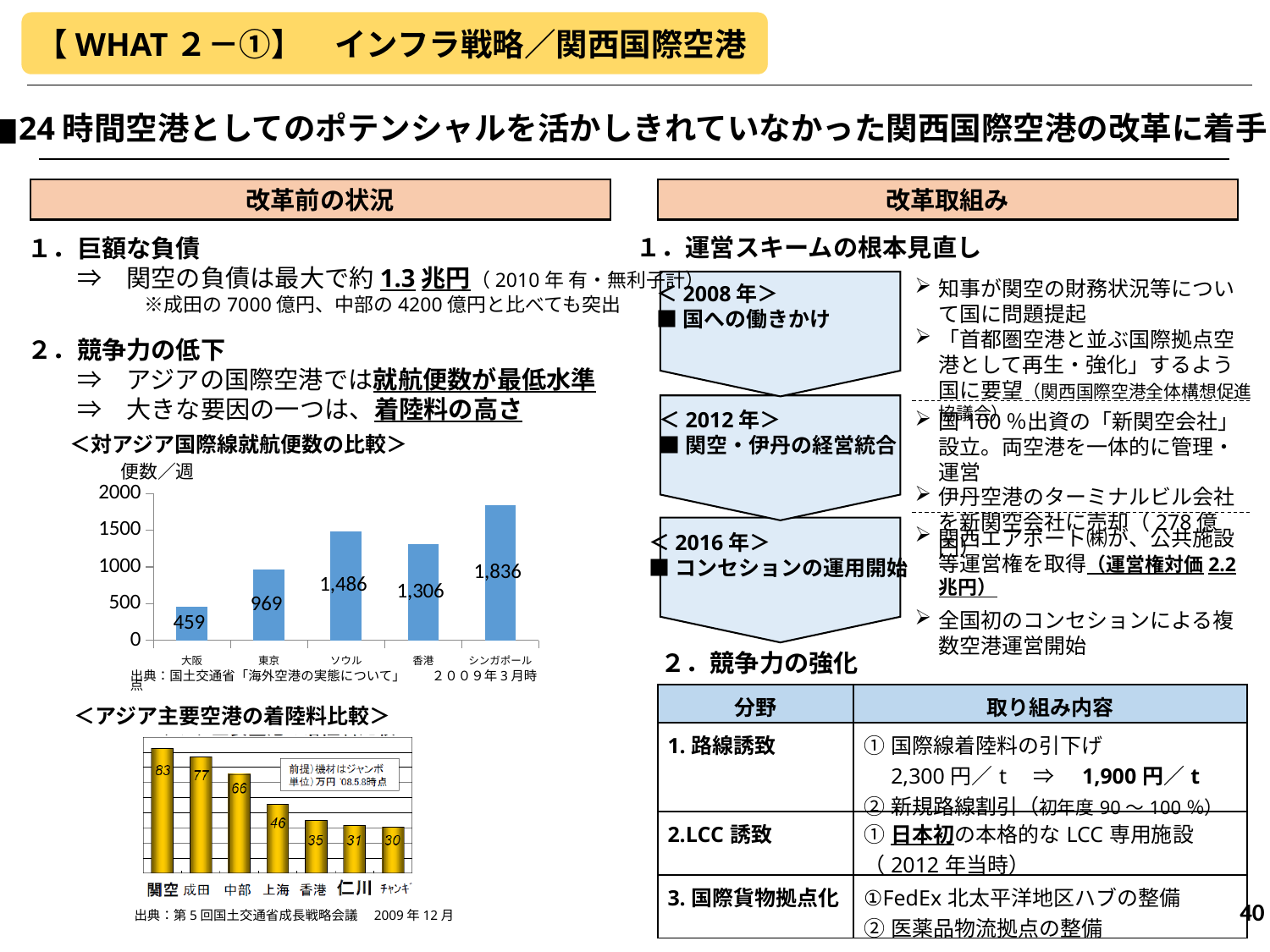
In the chart titled 対アジア国際線就航便数の比較, what is the difference between the values for ソウル and 香港? 180 In the chart titled アジア主要空港の着陸料比較, what is the difference between the values for 関空 and 成田? 6 In the chart titled 対アジア国際線就航便数の比較, which category has the highest value? シンガポール In the chart titled 対アジア国際線就航便数の比較, what kind of chart is it? bar chart In the chart titled 対アジア国際線就航便数の比較, what is the value for シンガポール? 1,836 In the chart titled 対アジア国際線就航便数の比較, which category has the lowest value? 大阪 In the chart titled アジア主要空港の着陸料比較, which airport has the lowest value? チャンギ In the chart titled アジア主要空港の着陸料比較, what is the value for 関空? 83 In the chart titled 対アジア国際線就航便数の比較, which is larger, the value for 東京 or the value for 香港? 香港 In the chart titled 対アジア国際線就航便数の比較, how many categories are plotted? 5 In the chart titled アジア主要空港の着陸料比較, do the values rise or fall from left to right? fall In the chart titled 対アジア国際線就航便数の比較, what is the value for 大阪? 459